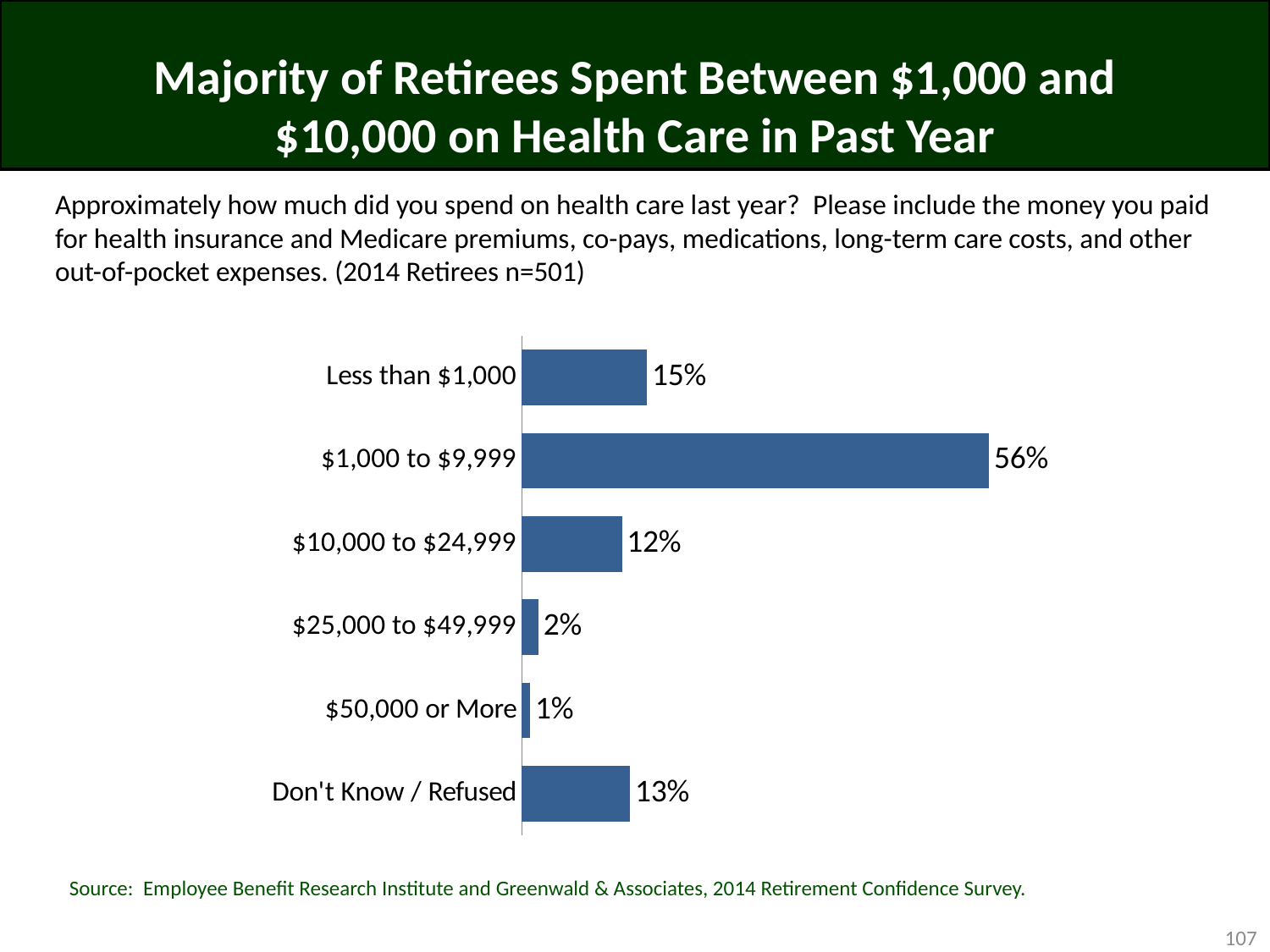
How many spending categories are shown in the chart? 6 What is the combined percentage of retirees who spent $25,000 to $49,999 and $50,000 or more? 3% What percentage of retirees spent $1,000 to $9,999 on health care last year? 56% Which spending category has the highest percentage of retirees? $1,000 to $9,999 Which spending category has the lowest percentage of retirees? $50,000 or More What is the difference in percentage points between the $1,000 to $9,999 category and the $10,000 to $24,999 category? 44 Which is larger: the percentage for Less than $1,000 or the percentage for $10,000 to $24,999? Less than $1,000 What percentage of retirees answered Don't Know / Refused? 13% What is the sample size of 2014 retirees noted in the survey question? n=501 What type of chart is shown on the slide? Bar chart What percentage of retirees spent $50,000 or more on health care last year? 1% What percentage of retirees spent less than $1,000 on health care last year? 15%